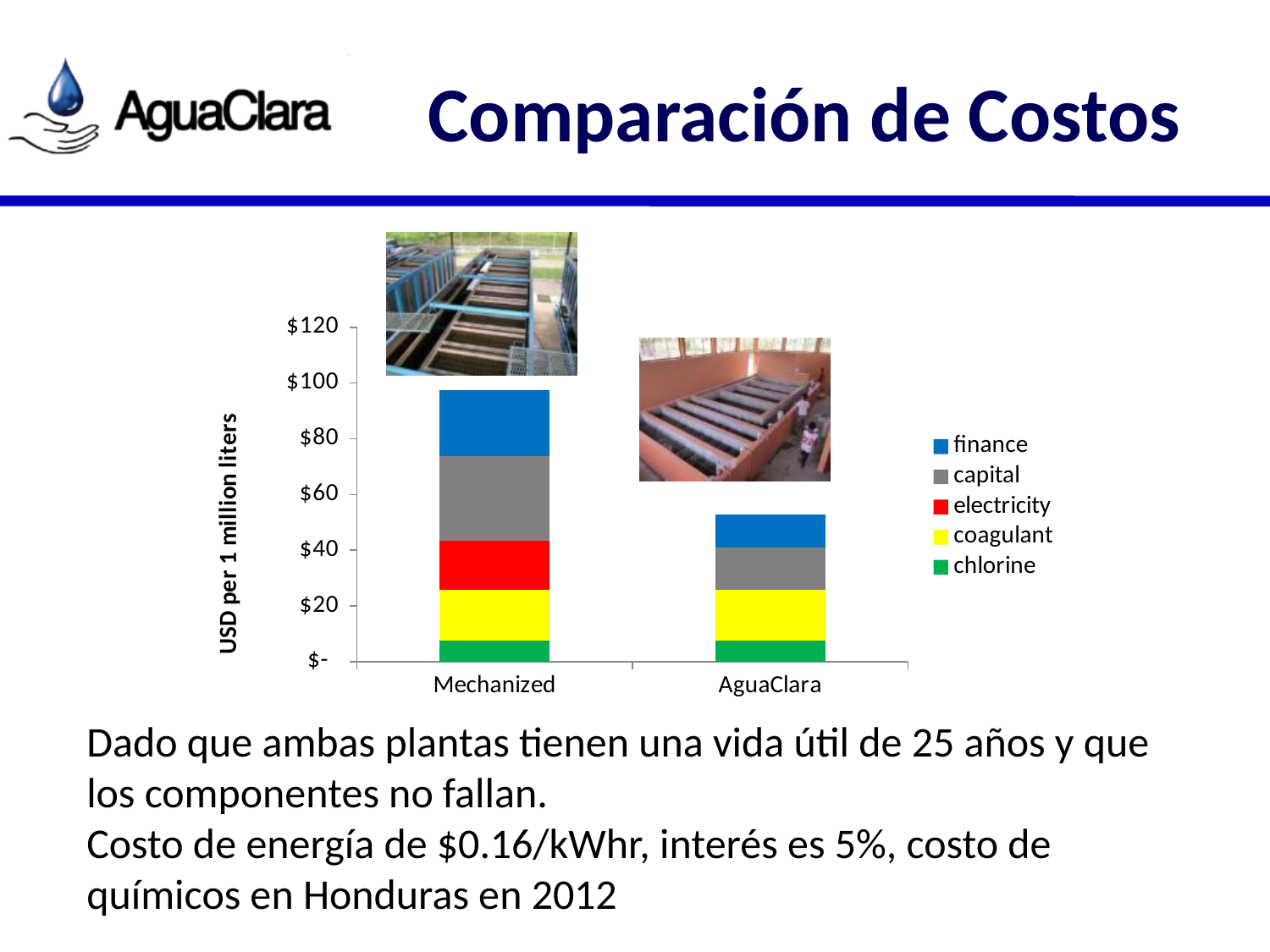
What is the label of the y axis of the chart? USD per 1 million liters Is the total value for Mechanized greater or less than $80? greater Is the total value for AguaClara greater or less than $60? less How many categories are shown on the x axis of the chart? 2 Which category has the highest total cost in the chart? Mechanized How many series does the chart legend list? 5 Which colour represents the capital series in the chart? Gray Which category has the lowest total cost in the chart? AguaClara What kind of chart is shown on the slide? Stacked bar chart Which category has the higher total cost, Mechanized or AguaClara? Mechanized Which cost component appears in the Mechanized bar but not in the AguaClara bar? electricity Is the total value for AguaClara greater or less than $40? greater